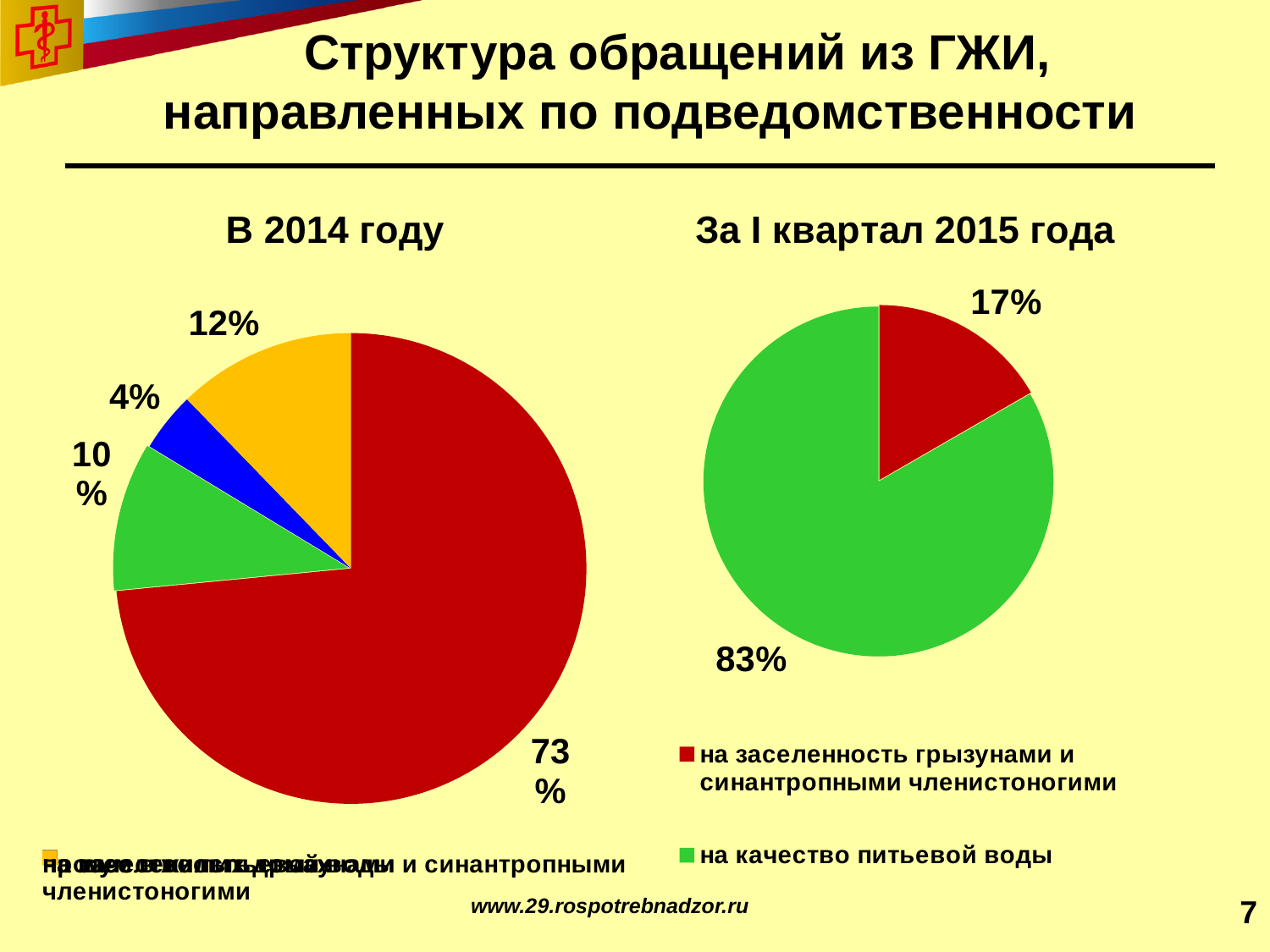
In the chart titled "В 2014 году", what is the value of the smallest slice? 4% In the chart titled "В 2014 году", how many slices does the pie have? 4 In the chart titled "За I квартал 2015 года", which category is larger: "на качество питьевой воды" or "на заселенность грызунами и синантропными членистоногими"? на качество питьевой воды What kind of chart is the chart titled "В 2014 году"? pie chart In the chart titled "В 2014 году", what is the difference between the yellow slice and the green slice? 2% In the chart titled "За I квартал 2015 года", how many categories does the legend list? 2 In the chart titled "За I квартал 2015 года", what share is shown for "на качество питьевой воды"? 83% In the chart titled "За I квартал 2015 года", what share is shown for "на заселенность грызунами и синантропными членистоногими"? 17% In the chart titled "В 2014 году", what is the value of the largest slice? 73% In the chart titled "В 2014 году", what value is shown for the green slice? 10% In the chart titled "В 2014 году", what value is shown for the yellow slice? 12% In the chart titled "За I квартал 2015 года", what colour is the slice for "на качество питьевой воды"? green